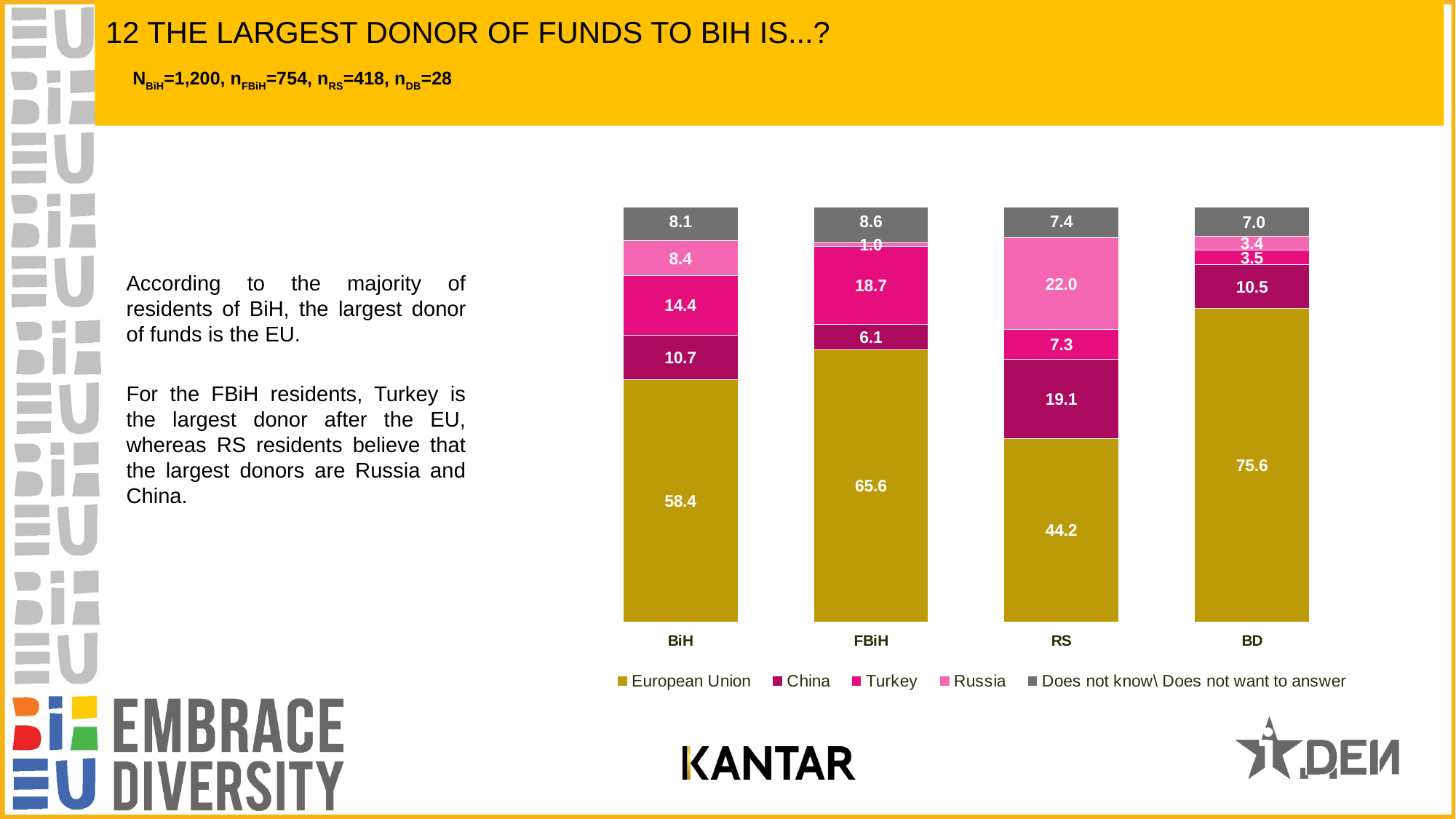
What is the value for China in the BD bar? 10.5 Which category has the lowest value for European Union? RS What is the difference between the European Union values for BD and RS? 31.4 Which category has the highest value for European Union? BD What is the value for Turkey in the FBiH bar? 18.7 What is the total of the stacked bar for RS? 100.0 What percentage of BiH residents named the European Union as the largest donor? 58.4 What is the value for Russia in the RS bar? 22.0 What kind of chart is shown on the slide? Stacked bar chart How many series does the legend list? 5 Is the China value larger for RS or for BiH? RS How many categories are shown on the x axis? 4